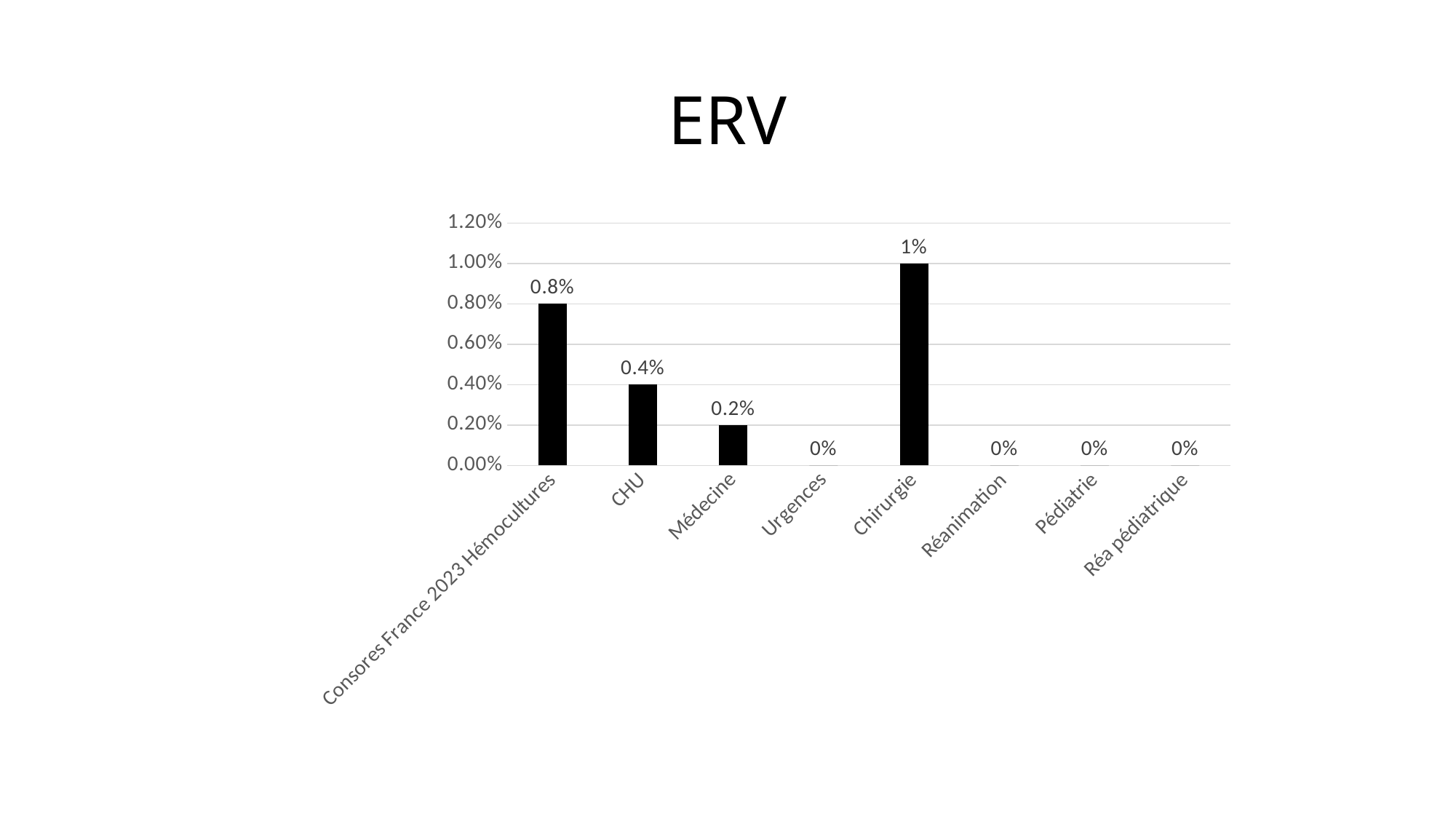
What is the value for Médecine? 0.2% What is the value for Réanimation? 0% Which is larger, the value for CHU or the value for Médecine? CHU What is the value for Chirurgie? 1% What kind of chart is shown on the slide? Bar chart What is the title of the chart? ERV What is the value for Consores France 2023 Hémocultures? 0.8% What is the difference between the values for Chirurgie and CHU? 0.6% What is the value for CHU? 0.4% How many categories are shown on the x axis? 8 What is the difference between the values for Consores France 2023 Hémocultures and Médecine? 0.6% Which category has the highest value? Chirurgie